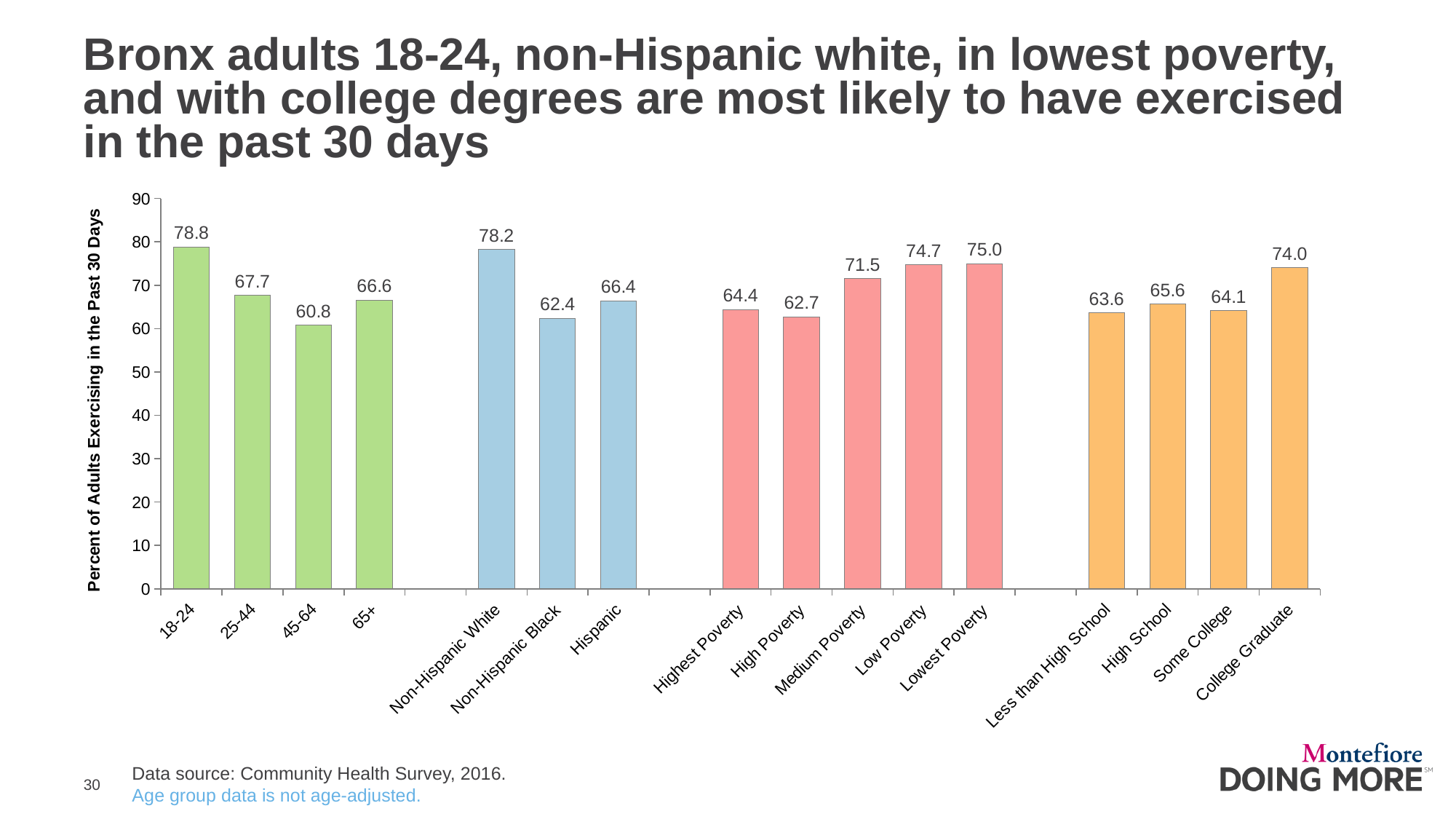
What kind of chart is shown on the slide? bar chart What is the difference between the values for Non-Hispanic White and Hispanic? 11.8 What is the value for the 18-24 age group? 78.8 What is the label of the vertical axis? Percent of Adults Exercising in the Past 30 Days Which category has the lowest value on the chart? 45-64 How many categories are plotted on the chart? 16 What is the value for Non-Hispanic Black adults? 62.4 Which is larger, the value for High School or the value for Some College? High School What is the value for College Graduate? 74.0 Is the value for Medium Poverty greater or less than 70? greater What is the value for the Lowest Poverty category? 75.0 Which category has the highest value on the chart? 18-24